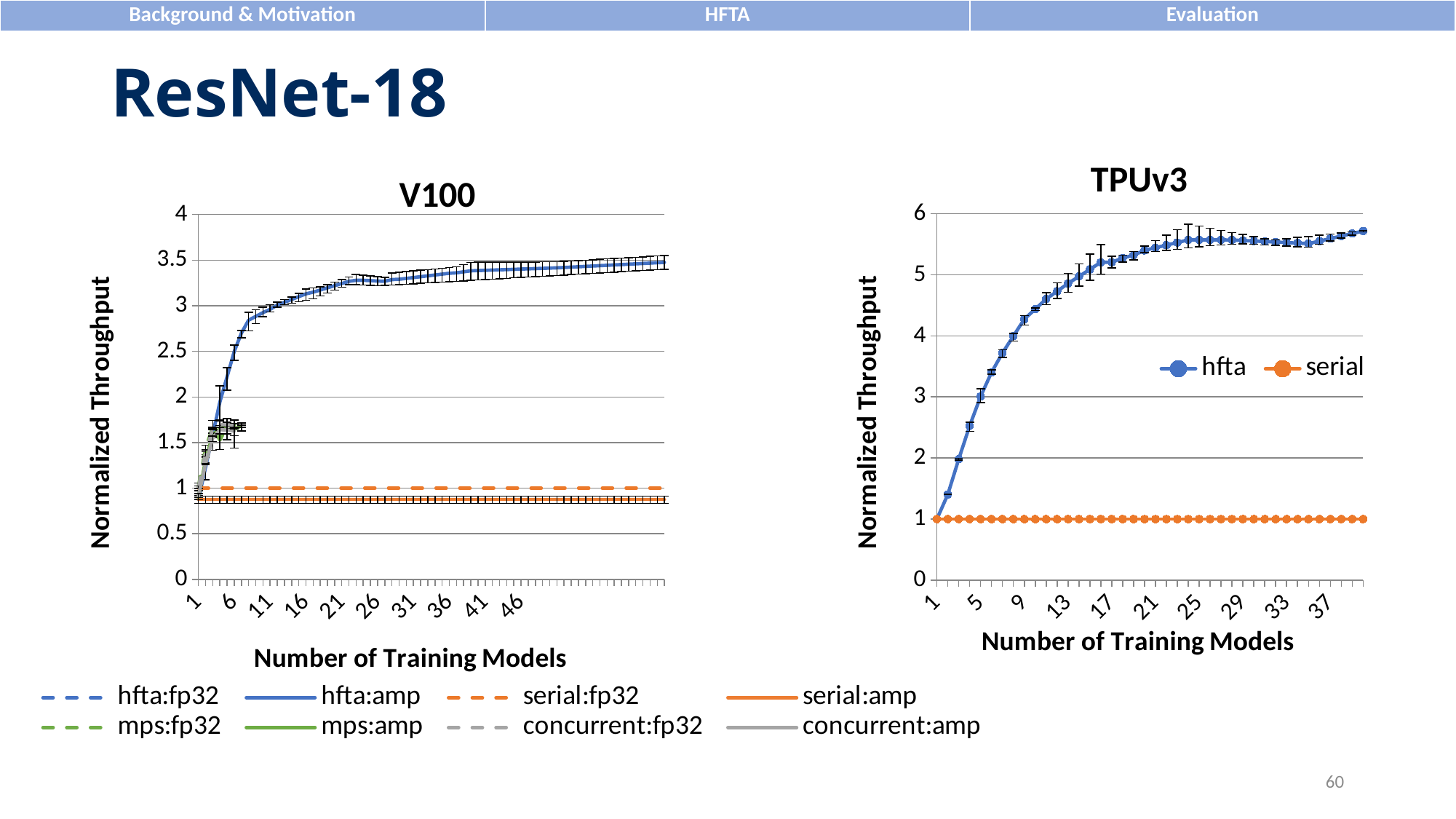
In the TPUv3 chart, does the hfta series rise or fall as the number of training models increases? rise What kind of chart is the V100 chart? line chart What is the title of the chart on the right side of the slide? TPUv3 In the TPUv3 chart, which series has the larger value at 21 training models, hfta or serial? hfta In the TPUv3 chart, does the serial series rise, fall, or stay flat as the number of training models increases? stay flat How many series does the legend of the V100 chart list? 8 In the TPUv3 chart, is the value of hfta at 5 training models greater or less than 4? less How many series does the legend of the TPUv3 chart list? 2 In the TPUv3 chart, is the value of hfta at 37 training models greater or less than 5? greater In the V100 chart, is the value of serial:amp greater or less than 1? less What is the y-axis label of the V100 chart? Normalized Throughput